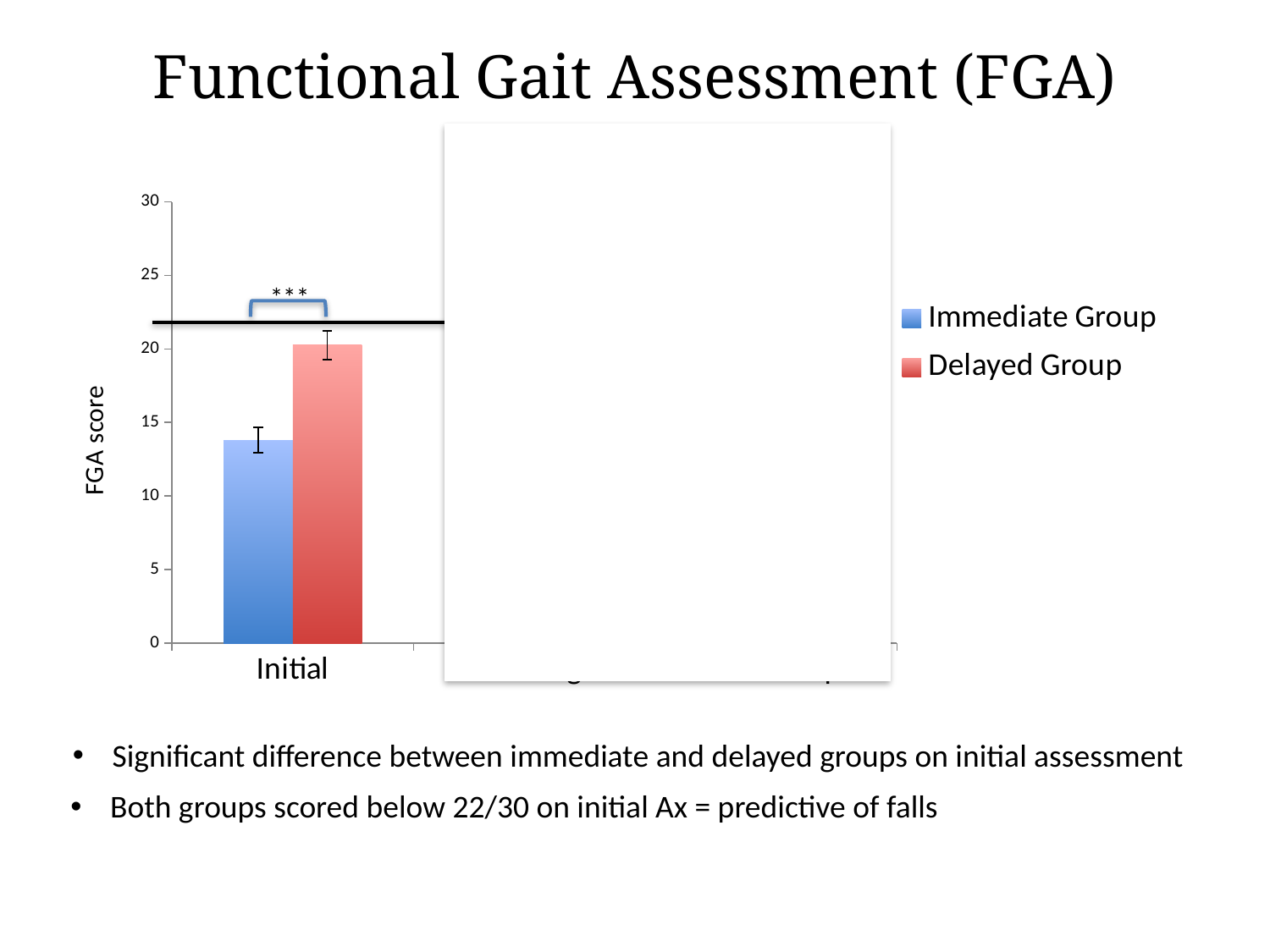
How many series does the legend list? 2 Is the Initial value for the Delayed Group greater or less than 15? greater What is the highest tick value shown on the vertical axis? 30 For the Initial category, which group has the higher FGA score, the Immediate Group or the Delayed Group? Delayed Group Is the Initial value for the Immediate Group greater or less than 15? less What are the two series named in the legend? Immediate Group and Delayed Group What kind of chart is shown on the slide? bar chart Is the Initial value for the Delayed Group greater or less than 25? less For the Initial category, which group has the lower FGA score? Immediate Group What is the label on the vertical axis? FGA score